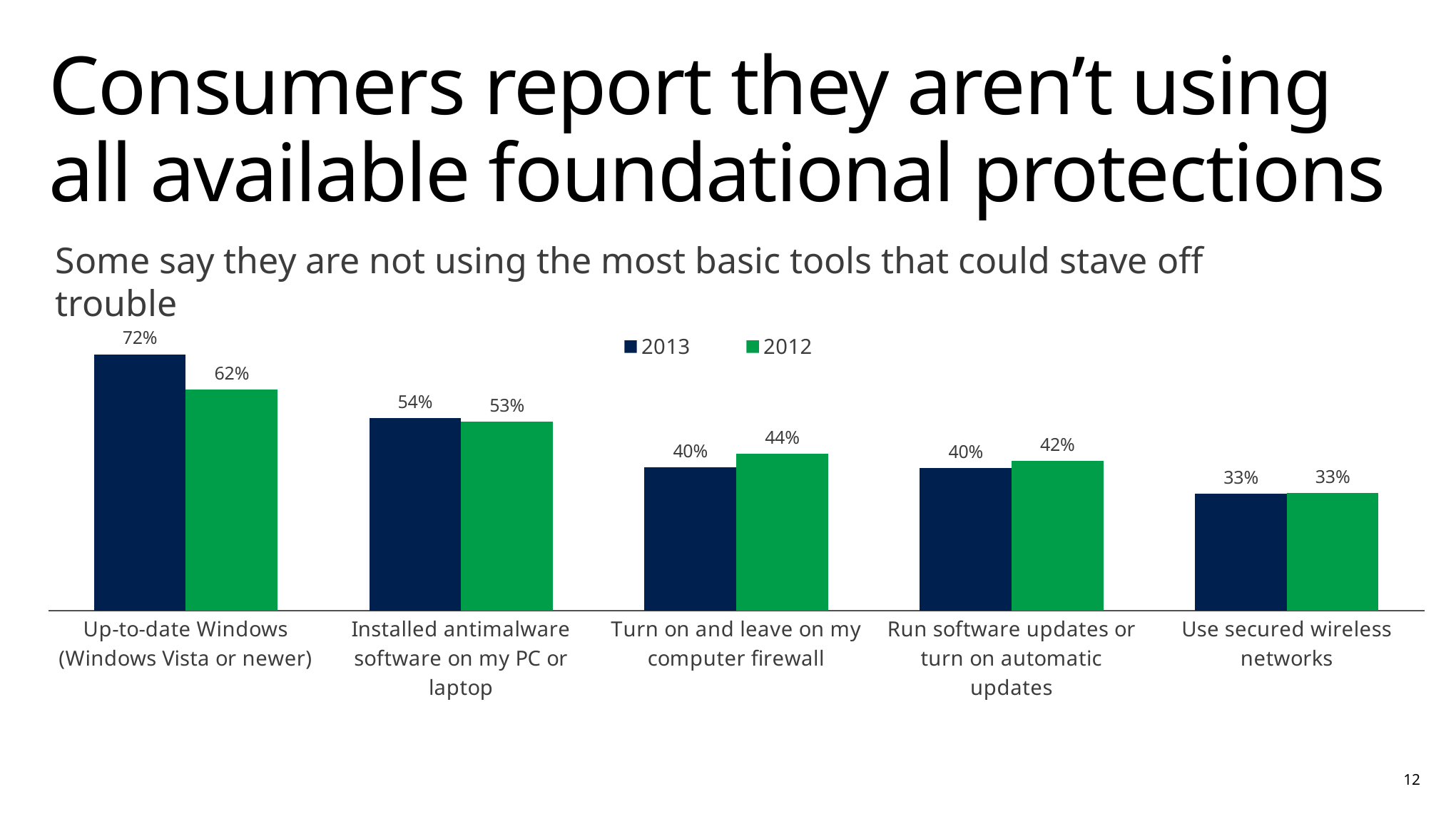
For "Run software updates or turn on automatic updates", which year has the larger value, 2013 or 2012? 2012 What kind of chart is shown on the slide? Bar chart How many categories are shown on the x axis? 5 Which series is shown in green in the legend? 2012 Which category has the highest 2013 value? Up-to-date Windows (Windows Vista or newer) What is the 2013 value for "Up-to-date Windows (Windows Vista or newer)"? 72% Which category has the lowest 2012 value? Use secured wireless networks How many series does the legend list? 2 What is the difference between the 2012 and 2013 values for "Turn on and leave on my computer firewall"? 4% What is the difference between the 2013 and 2012 values for "Up-to-date Windows (Windows Vista or newer)"? 10% What is the 2012 value for "Turn on and leave on my computer firewall"? 44% What is the 2013 value for "Use secured wireless networks"? 33%